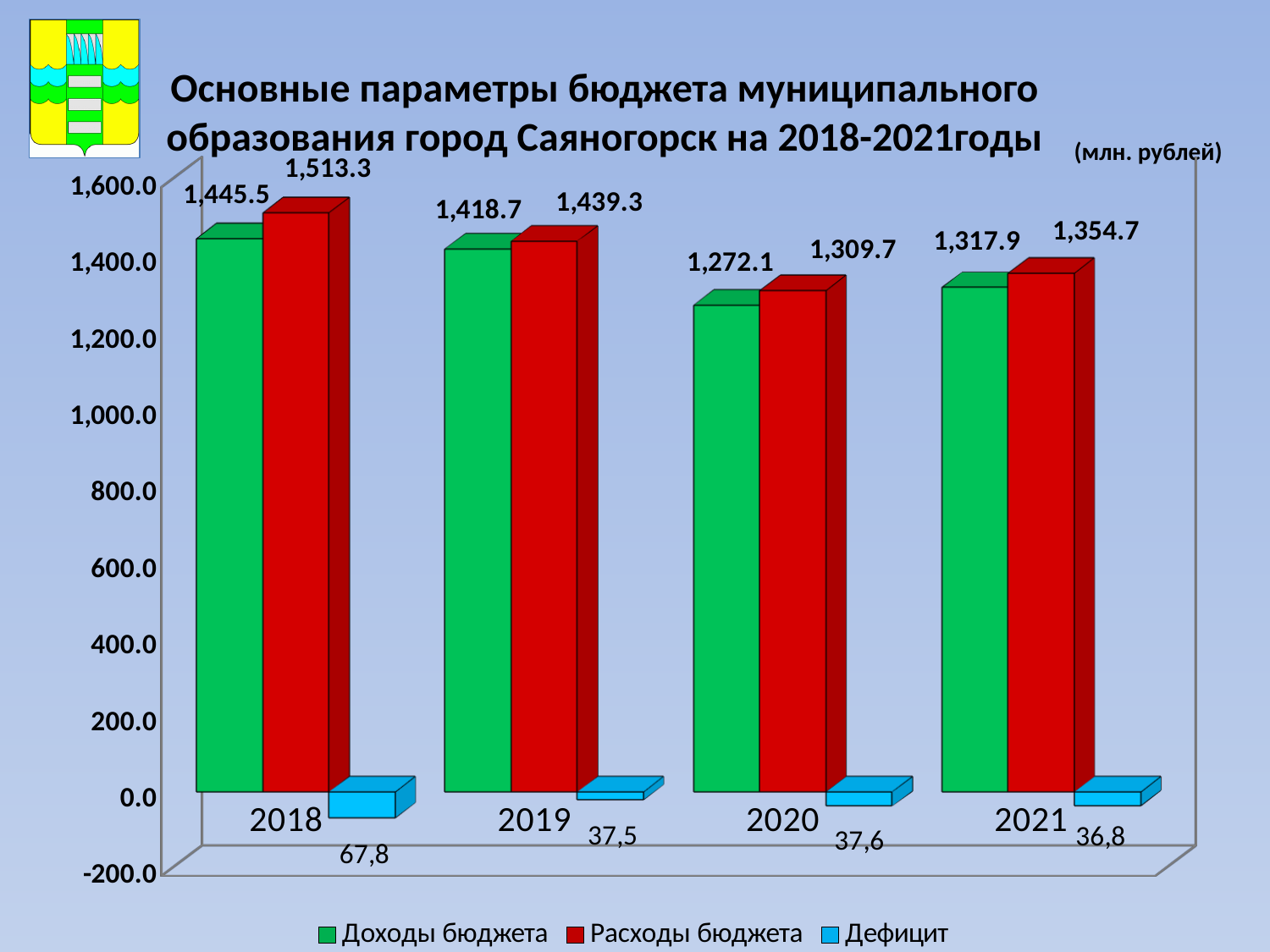
Which colour represents Дефицит in the legend? Blue How many series does the legend list? 3 What is the value of Расходы бюджета for 2020? 1,309.7 In which year is Доходы бюджета lowest? 2020 How many years are shown on the x axis? 4 Which is larger in 2019: Доходы бюджета or Расходы бюджета? Расходы бюджета Is the value of Доходы бюджета for 2020 greater or less than 1,400.0? less What is the value of Доходы бюджета for 2018? 1,445.5 What is the Дефицит value labelled for 2019? 37,5 What kind of chart is shown on the slide? Bar chart In which year is Расходы бюджета highest? 2018 What is the difference between Расходы бюджета and Доходы бюджета in 2021? 36.8